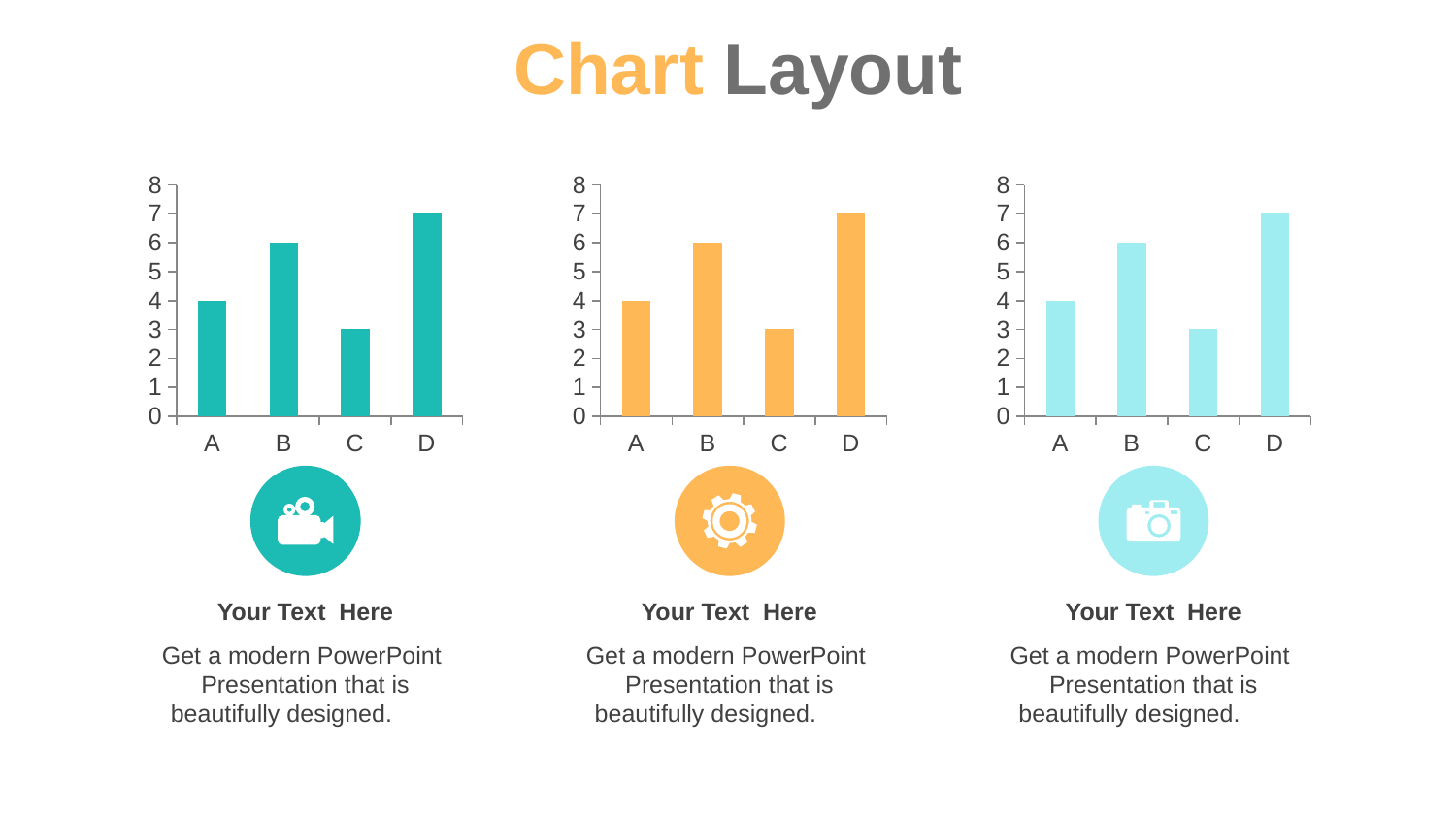
In the left chart, what is the value for category D? 7 In the middle chart, is the value for B greater or less than 5? greater In the right chart, what is the value for category C? 3 What kind of chart is the middle chart? bar chart What colour are the bars in the middle chart? orange In the middle chart, which category has the lowest value? C How many bar charts are on the slide? 3 In the left chart, which category has the highest value? D In the left chart, which is larger, the value for B or the value for A? B In the right chart, what is the difference between the values for D and C? 4 How many categories are shown on the x axis of the right chart? 4 In the middle chart, what is the value for category A? 4